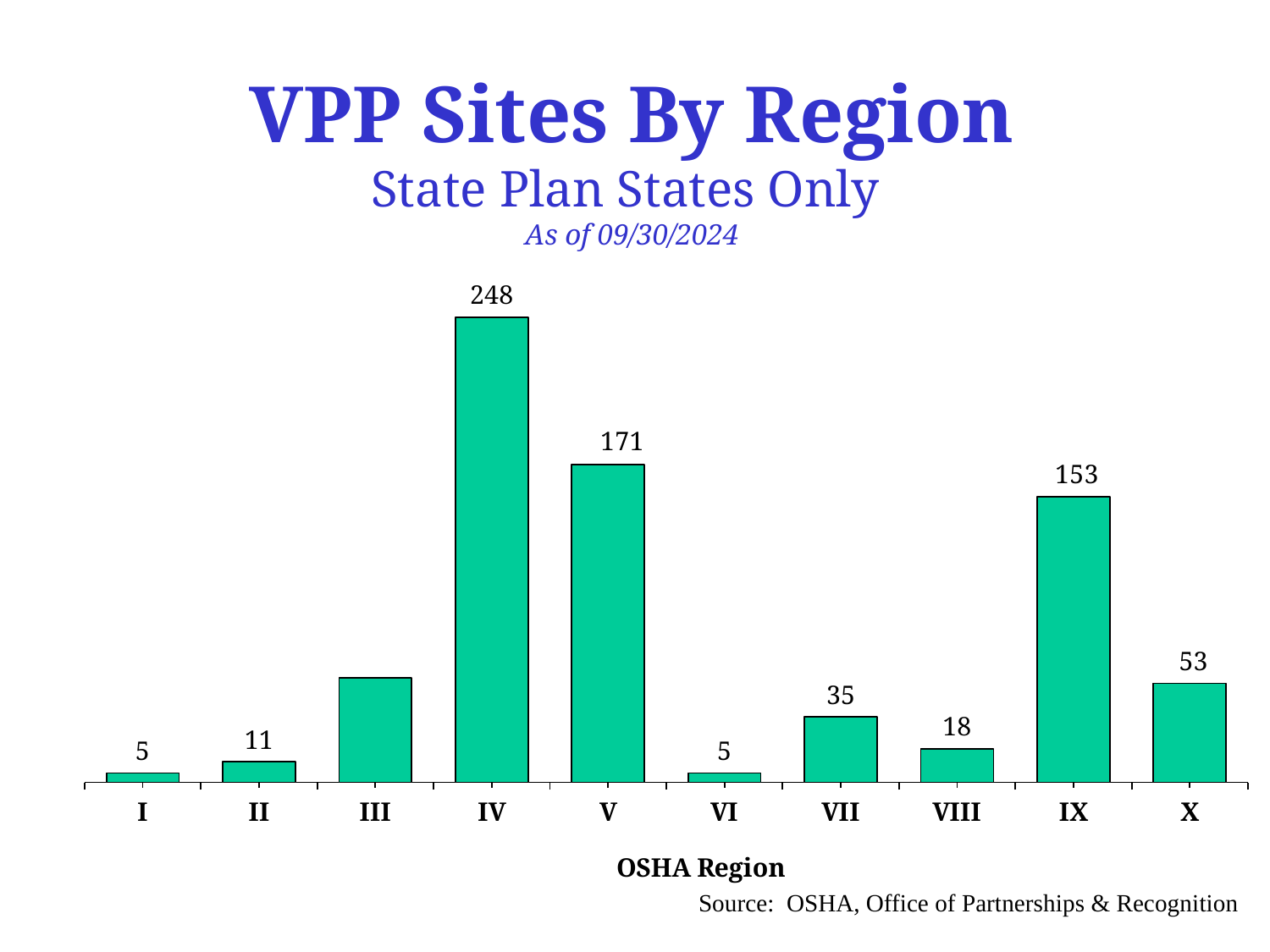
Which OSHA region has the highest number of VPP sites? IV How many VPP sites are shown for Region IV? 248 What is the value for Region VIII? 18 What is the x-axis title of the chart? OSHA Region What is the value for Region V? 171 How many OSHA regions are shown on the x axis? 10 What is the value for Region X? 53 What is the difference between the values for Region IV and Region V? 77 What kind of chart is shown on the slide? Bar chart What is the difference between the values for Region IX and Region X? 100 Which has a larger value, Region V or Region IX? Region V What is the value for Region IX? 153